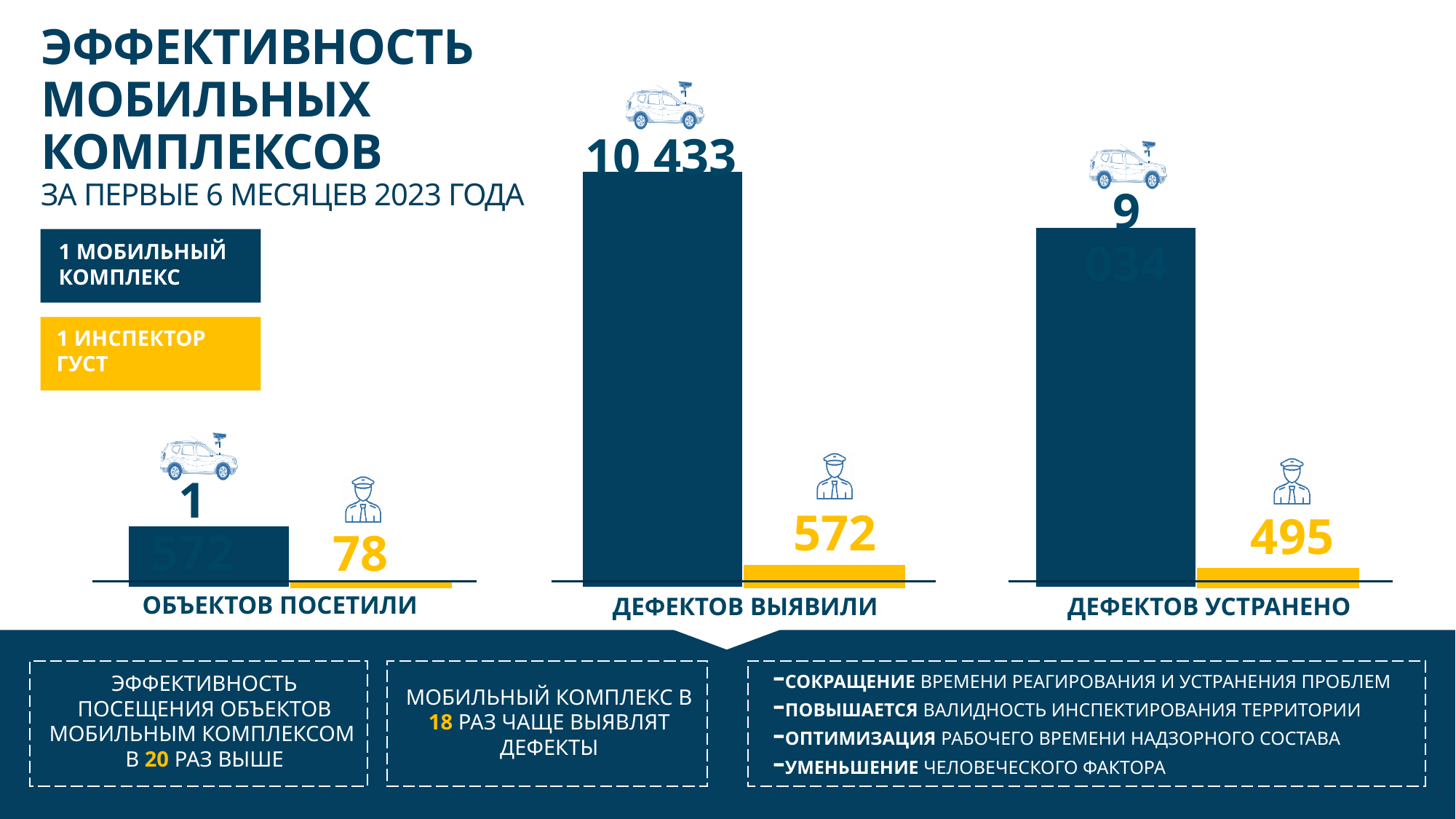
How many objects did one GUST inspector visit (Объектов посетили)? 78 What is the difference between the number of defects identified by the mobile complex and by the inspector? 9 861 What is the difference between the number of defects identified and the number of defects fixed by the GUST inspector? 77 How many objects did one mobile complex visit (Объектов посетили)? 1 572 For the mobile complex series, which category has the highest value? Дефектов выявили How many defects did the mobile complex identify (Дефектов выявили)? 10 433 For the GUST inspector series, which category has the lowest value? Объектов посетили How many defects did one GUST inspector identify (Дефектов выявили)? 572 How many categories are shown along the bottom of the chart? 3 How many series does the legend list? 2 How many defects did one GUST inspector fix (Дефектов устранено)? 495 In the 'Дефектов устранено' group, which series has the larger value: the mobile complex or the GUST inspector? 1 мобильный комплекс